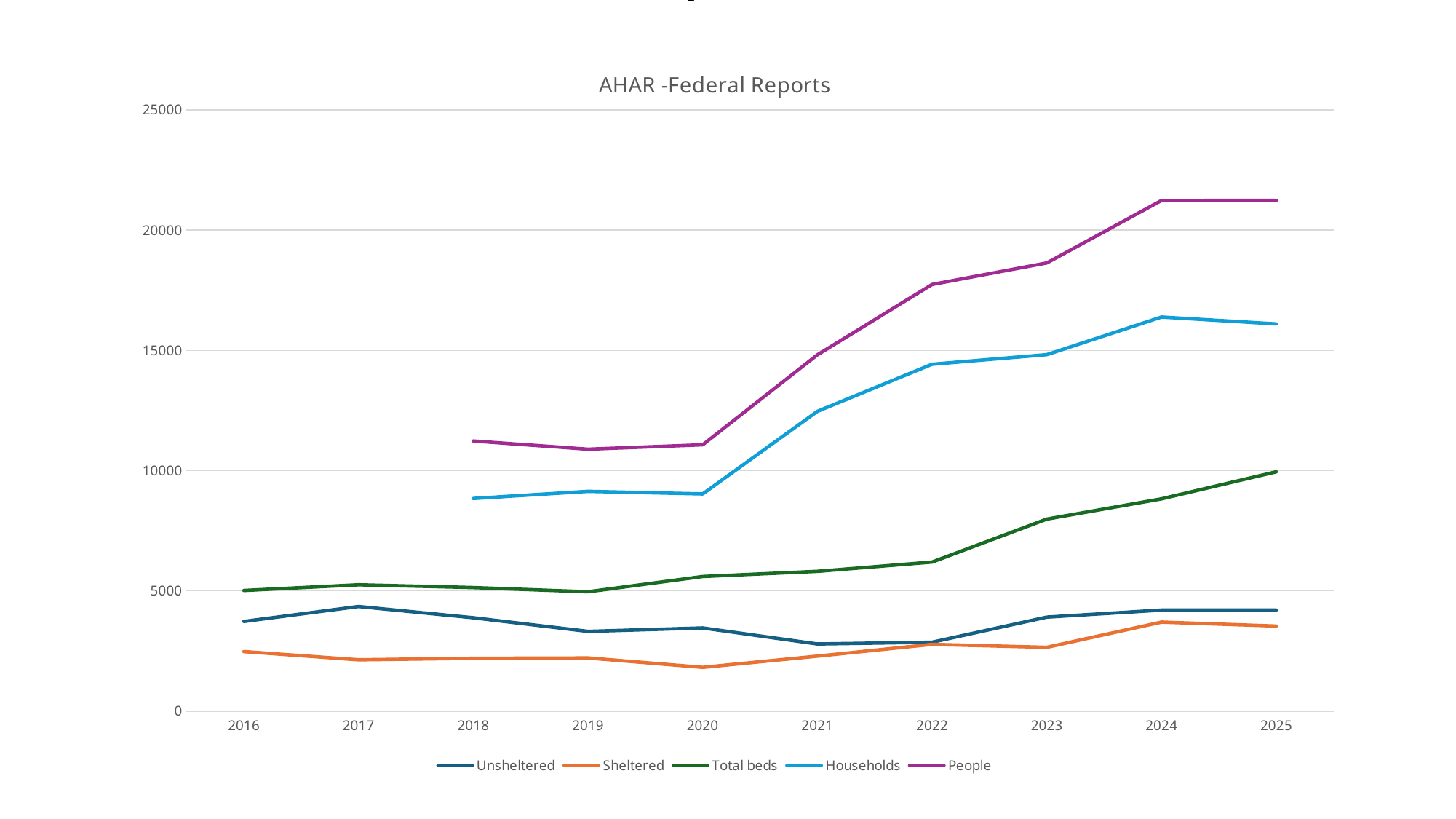
What type of chart is shown on the slide? Line chart How many series does the legend list? 5 Which series has the highest value in 2025? People Is the value for People in 2025 greater or less than 20000? greater What is the title of the chart? AHAR -Federal Reports Is the value for Households in 2018 greater or less than 10000? less Is the value for Total beds in 2023 greater or less than 5000? greater In 2022, which is larger: Households or Total beds? Households How many years are shown on the x axis? 10 Which series has the lowest value in 2025? Sheltered Does the People series rise or fall from 2020 to 2024? Rises In which year is the Sheltered series at its lowest? 2020